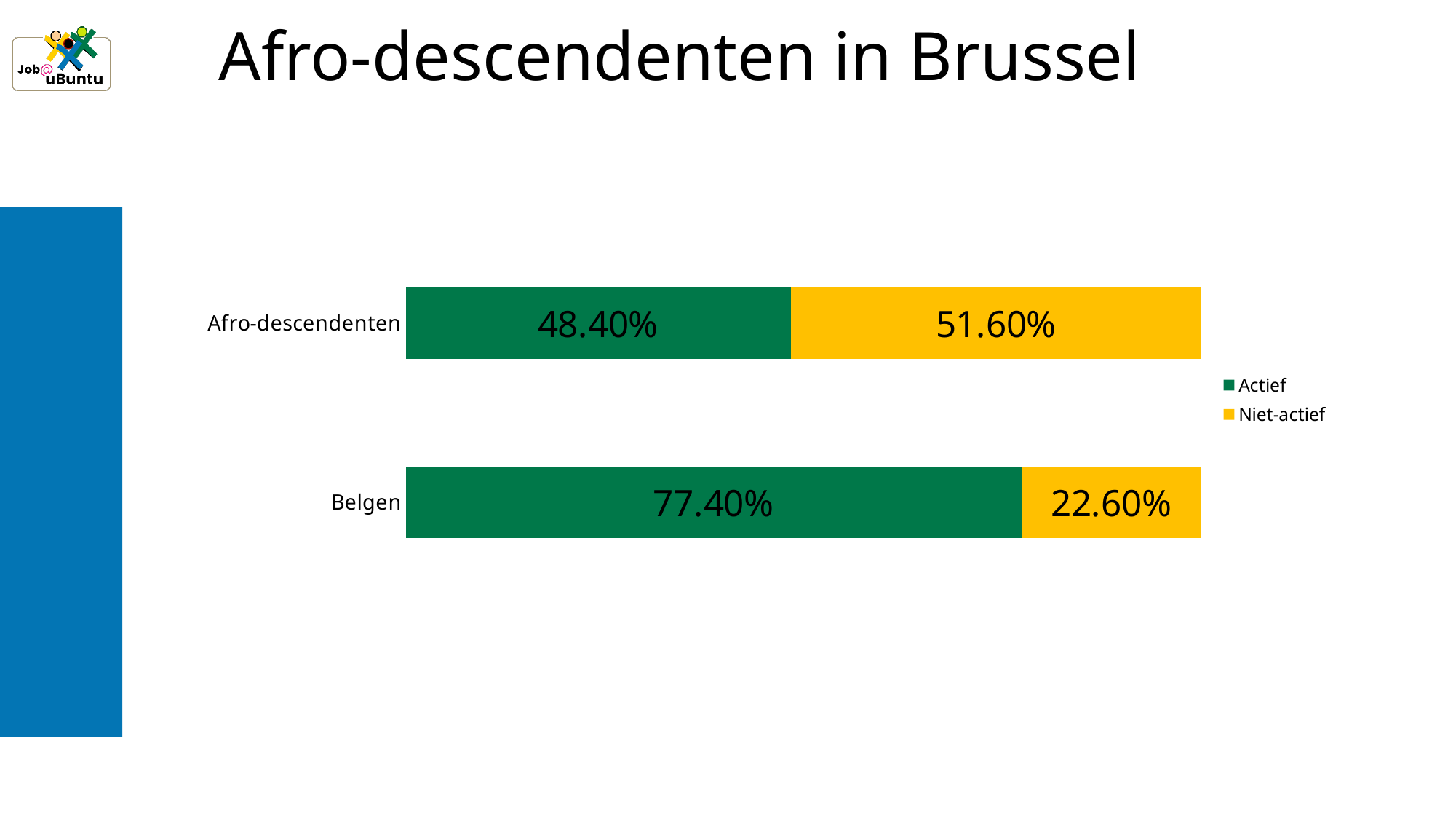
What is the difference between the Actief values for Belgen and Afro-descendenten? 29.00% What is the Niet-actief value for Afro-descendenten? 51.60% How many series does the legend list? 2 What is the Actief value for Afro-descendenten? 48.40% How many categories are shown on the chart? 2 Which colour represents the Niet-actief series? Yellow What is the Actief value for Belgen? 77.40% Which category has the lower Niet-actief value? Belgen Which category has the higher Actief value? Belgen What is the Niet-actief value for Belgen? 22.60% What kind of chart is shown on the slide? Stacked bar chart Is the Niet-actief value larger for Afro-descendenten or for Belgen? Afro-descendenten